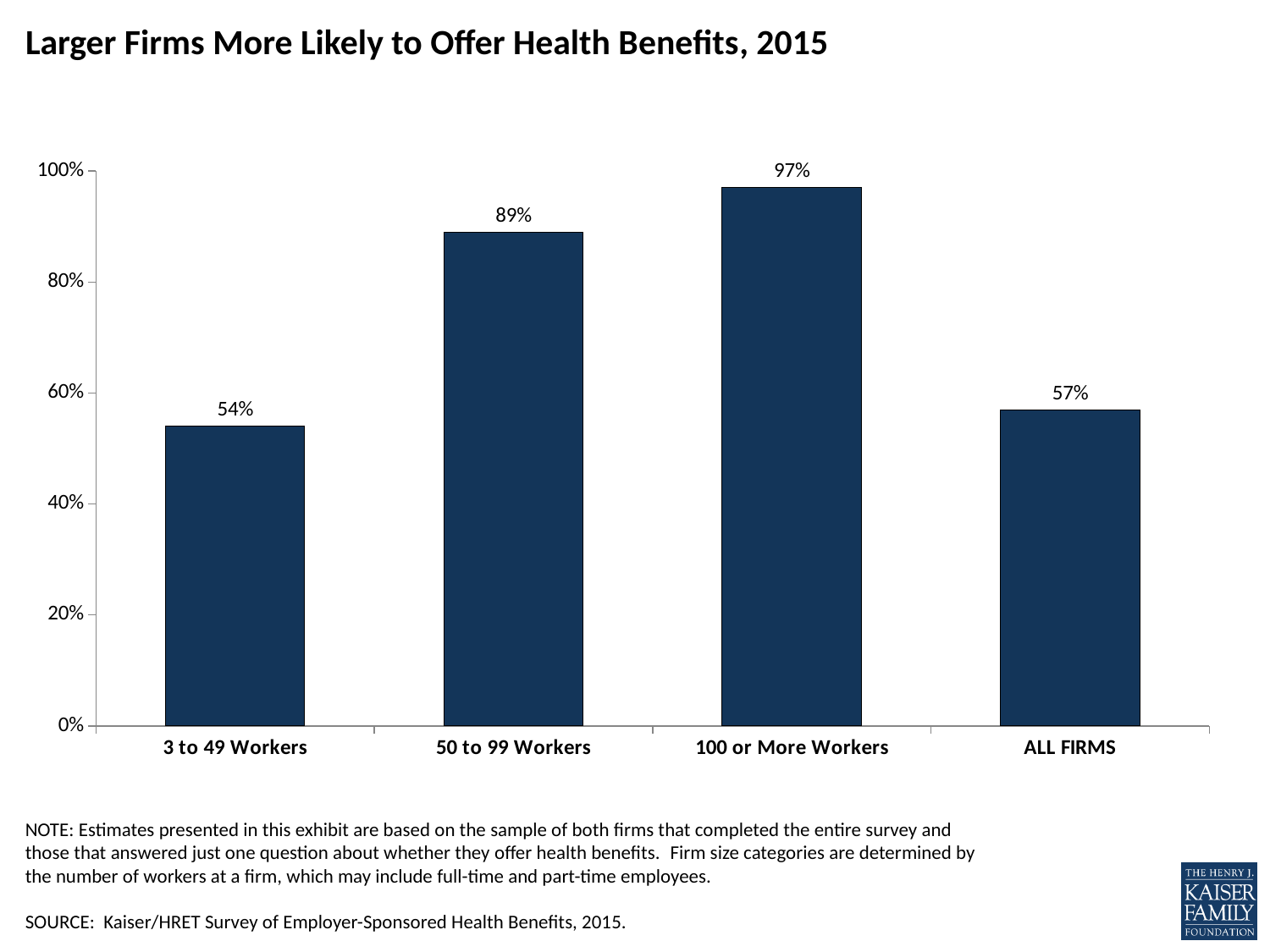
Is the value for 50 to 99 Workers greater or less than 80%? greater What kind of chart is shown on the slide? Bar chart What is the value shown for 100 or More Workers? 97% Which firm size category has the highest percentage offering health benefits? 100 or More Workers What is the value shown for ALL FIRMS? 57% What is the difference between the values for 100 or More Workers and 3 to 49 Workers? 43 percentage points Which is larger, the value for ALL FIRMS or the value for 3 to 49 Workers? ALL FIRMS How many categories are shown on the x axis? 4 What is the title of the chart? Larger Firms More Likely to Offer Health Benefits, 2015 What is the value shown for 50 to 99 Workers? 89% What percentage of firms with 3 to 49 workers offer health benefits? 54% Which category has the lowest value on the chart? 3 to 49 Workers